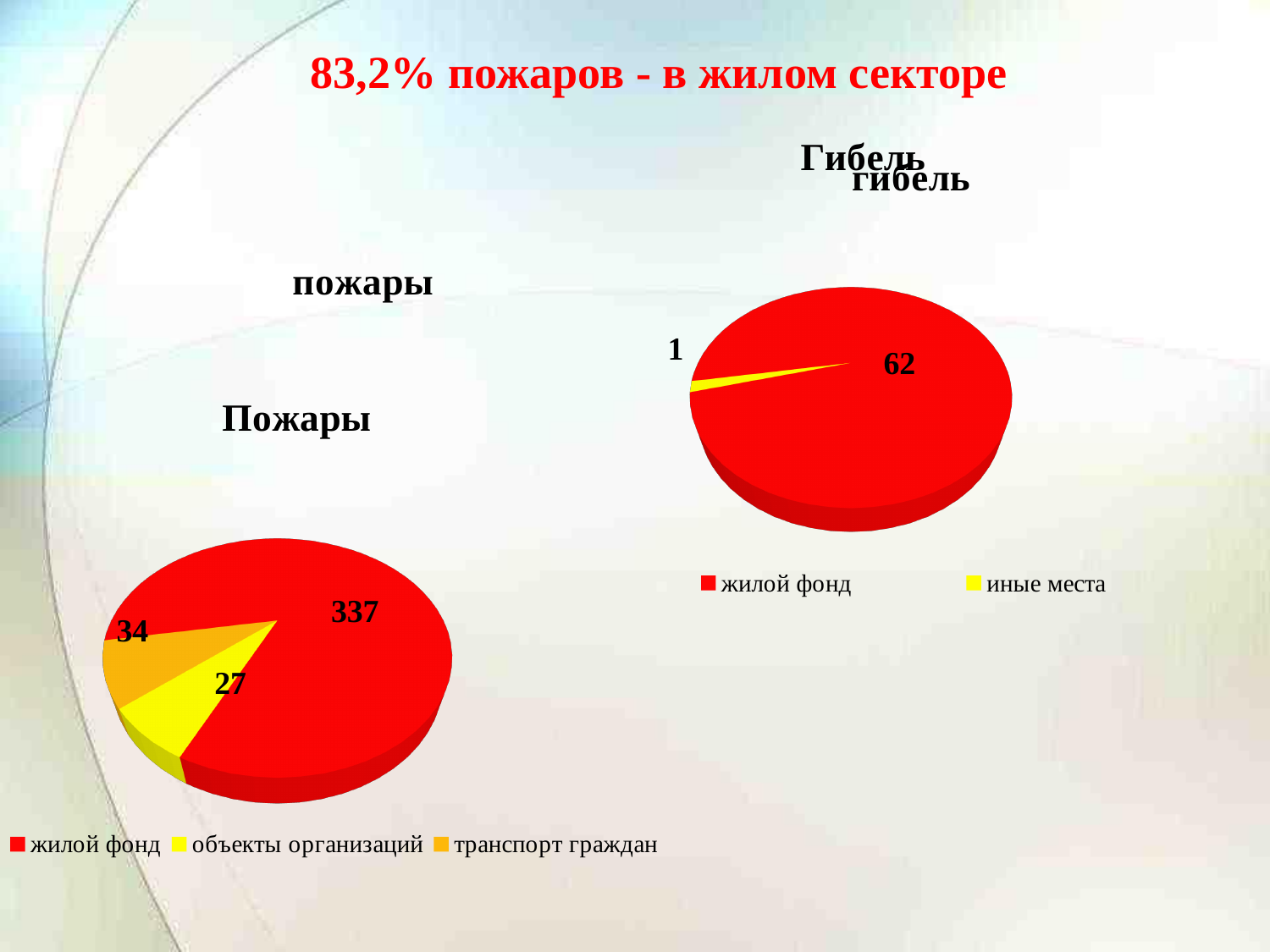
In the 'Гибель' pie chart, what is the difference between 'жилой фонд' and 'иные места'? 61 In the 'Пожары' pie chart, which category has the smallest value? объекты организаций In the 'Пожары' pie chart, what is the value for 'транспорт граждан'? 34 In the 'Пожары' pie chart, what is the difference between 'транспорт граждан' and 'объекты организаций'? 7 How many categories does the 'Пожары' pie chart show? 3 What type of chart is the 'Гибель' chart? pie chart In the 'Гибель' pie chart, what is the value for 'жилой фонд'? 62 In the 'Пожары' pie chart, which is larger: 'транспорт граждан' or 'объекты организаций'? транспорт граждан In the 'Пожары' pie chart, what is the value for 'объекты организаций'? 27 In the 'Пожары' pie chart, what is the value for 'жилой фонд'? 337 In the 'Пожары' pie chart, which category has the largest value? жилой фонд In the 'Гибель' pie chart, what is the value for 'иные места'? 1